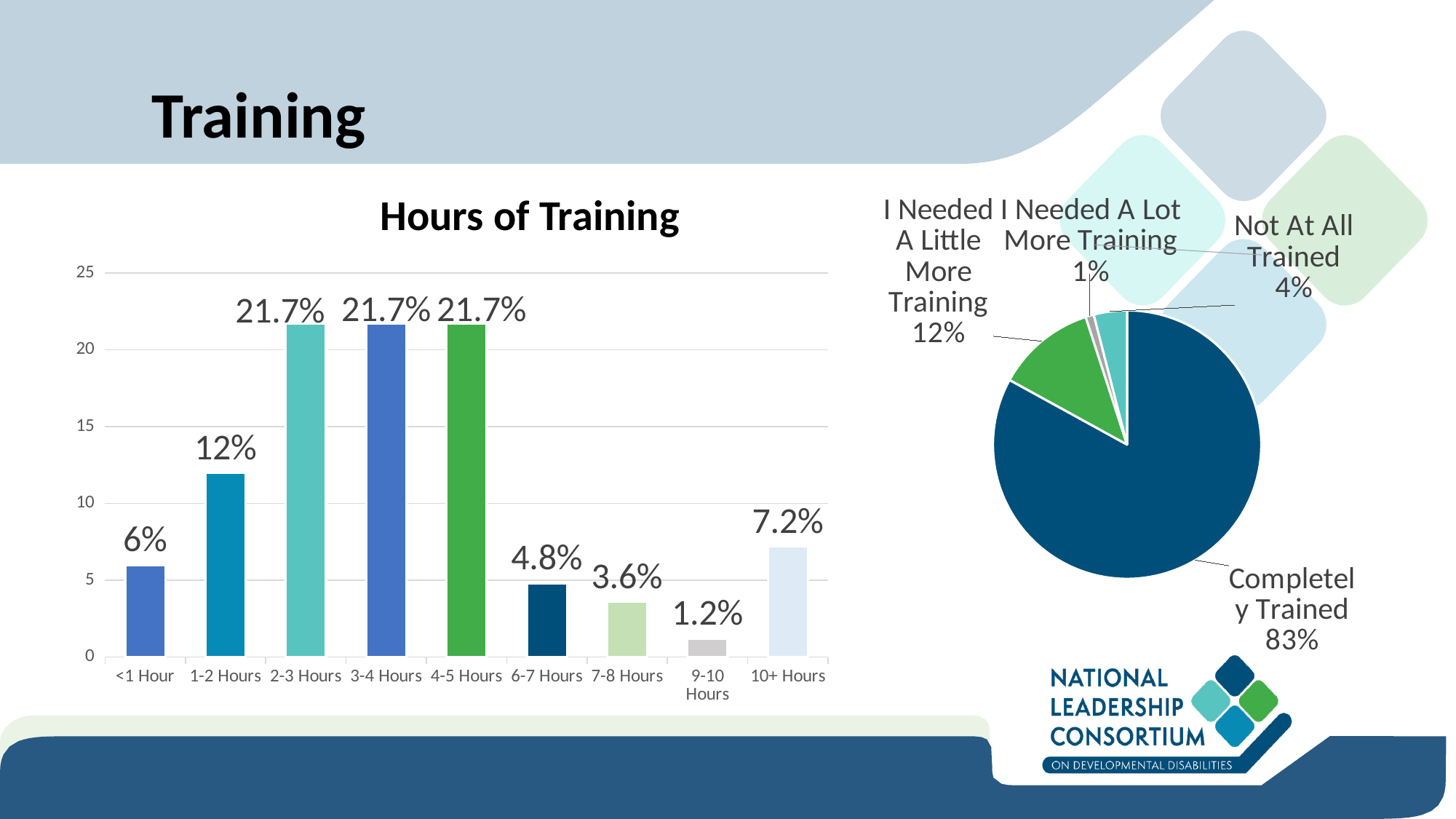
In the 'Hours of Training' chart, is the value for 2-3 Hours greater or less than 20? greater In the 'Hours of Training' chart, how many categories are shown on the x axis? 9 In the 'Hours of Training' chart, what is the value for 10+ Hours? 7.2% What kind of chart is the 'Hours of Training' chart? Bar chart In the pie chart on the right, what share is labelled 'Completely Trained'? 83% In the 'Hours of Training' chart, what is the difference between the values for 6-7 Hours and 7-8 Hours? 1.2% In the 'Hours of Training' chart, which category has the lowest value? 9-10 Hours In the pie chart on the right, what is the value for 'Not At All Trained'? 4% In the 'Hours of Training' chart, which is larger, the value for <1 Hour or the value for 10+ Hours? 10+ Hours In the 'Hours of Training' chart, what is the value for 1-2 Hours? 12% In the pie chart on the right, which slice is the smallest? I Needed A Lot More Training How many slices does the pie chart on the right have? 4